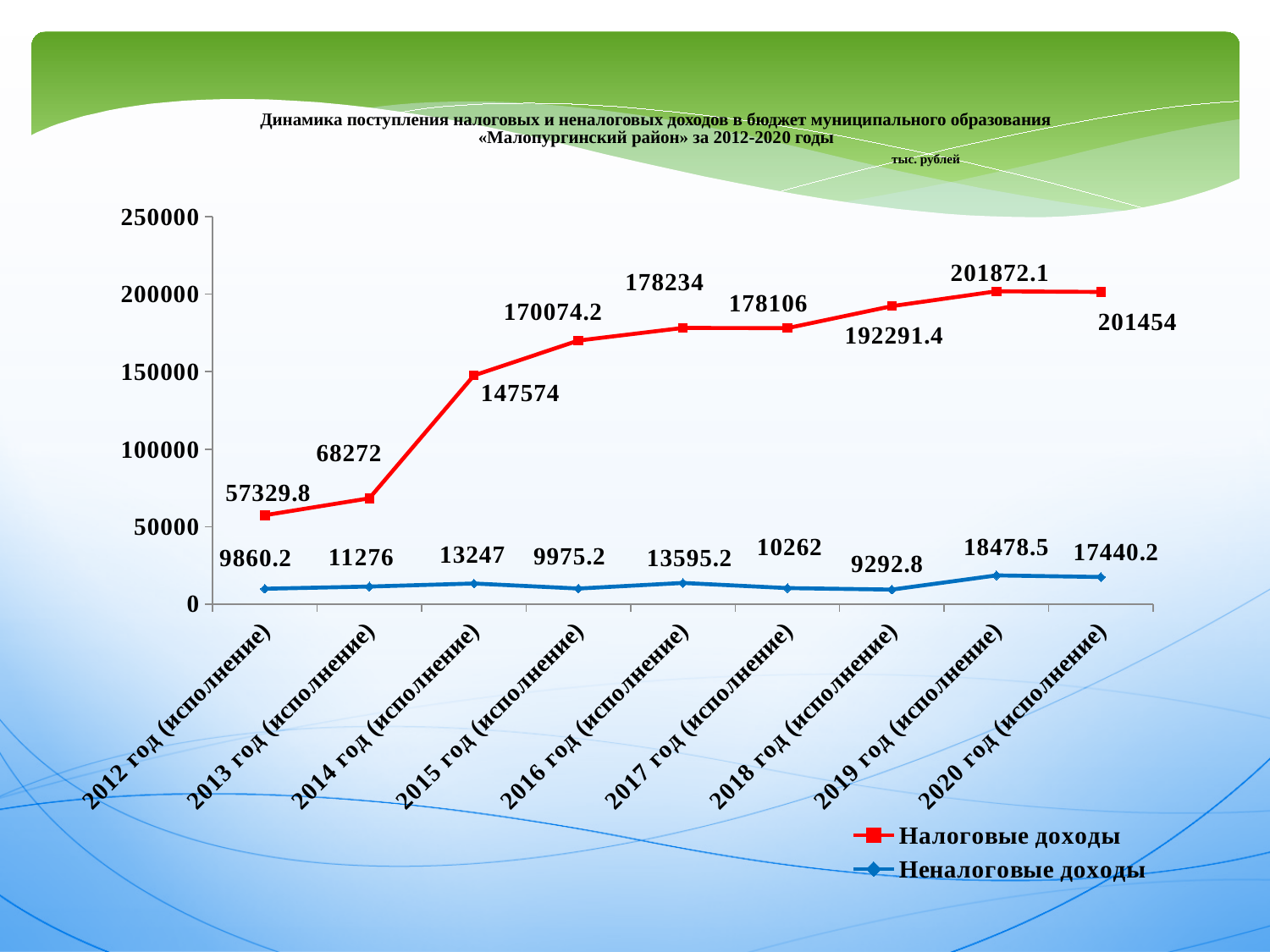
What is the value of Неналоговые доходы for 2019 год (исполнение)? 18478.5 Which series is drawn in red? Налоговые доходы Is the value of Налоговые доходы for 2012 год (исполнение) greater or less than 50000? greater In which year do Налоговые доходы reach their highest value? 2019 год (исполнение) Which is larger: Неналоговые доходы in 2016 or in 2017? 2016 (13595.2) In which year are Неналоговые доходы lowest? 2018 год (исполнение) What is the value of Налоговые доходы for 2018 год (исполнение)? 192291.4 What type of chart is shown on the slide? Line chart What is the value of Налоговые доходы for 2014 год (исполнение)? 147574 How many years (data points per series) are plotted on the x axis? 9 How many series does the legend list? 2 What is the difference between Налоговые доходы in 2014 and 2013? 79302